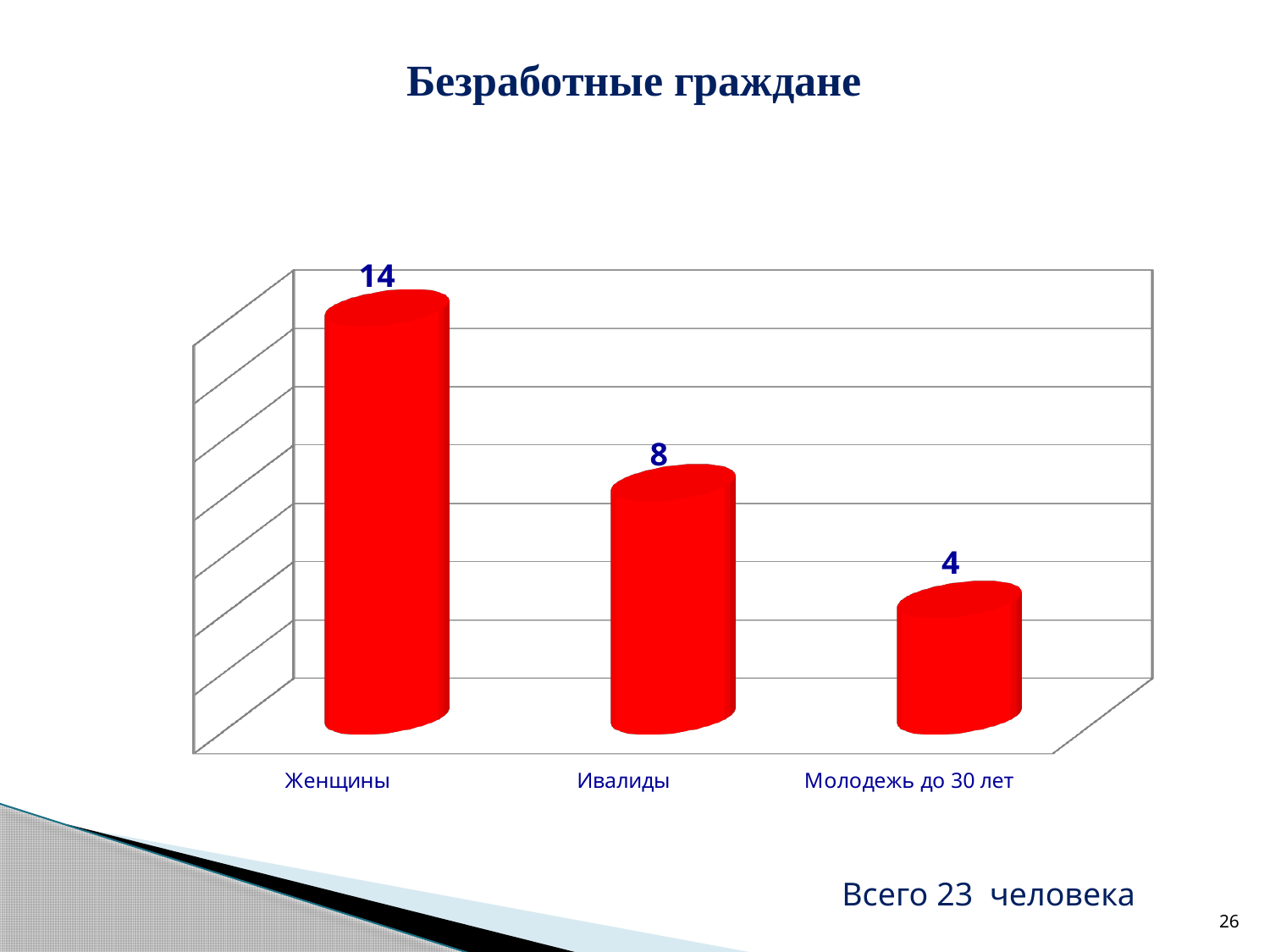
How many categories are shown in the chart? 3 What is the title of the chart? Безработные граждане What is the value for Женщины? 14 Which category has the highest value? Женщины Which is larger, the value for Женщины or the value for Молодежь до 30 лет? Женщины Do the values rise or fall from left to right across the categories? fall What is the value for Ивалиды? 8 What kind of chart is shown on the slide? bar chart What is the difference between the values for Женщины and Ивалиды? 6 What is the value for Молодежь до 30 лет? 4 Which category has the lowest value? Молодежь до 30 лет What is the difference between the values for Ивалиды and Молодежь до 30 лет? 4